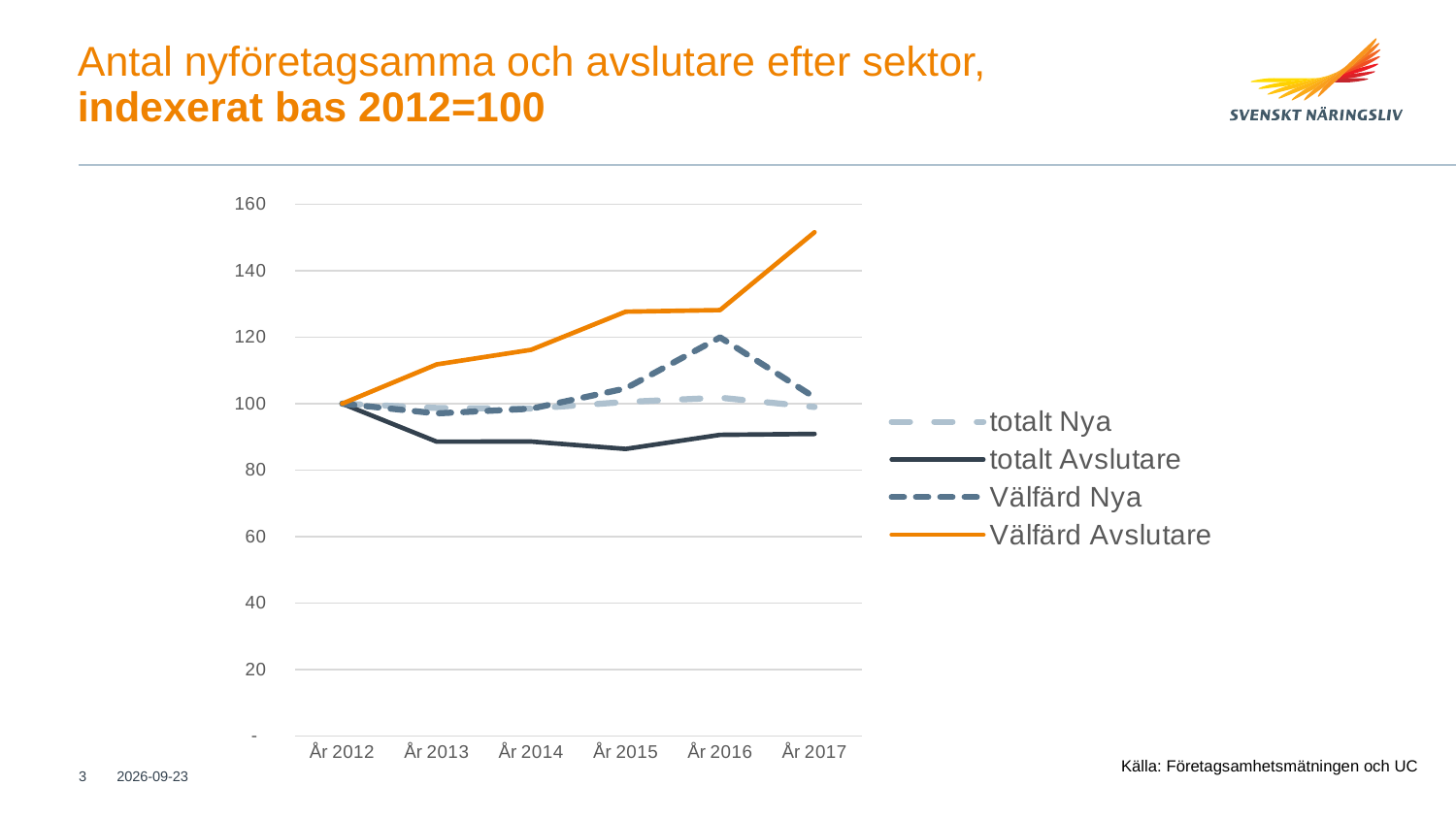
Is the value for Välfärd Avslutare in År 2017 greater or less than 140? greater Which series is drawn in orange? Välfärd Avslutare Is the value for totalt Avslutare in År 2015 greater or less than 100? less Is the value for Välfärd Avslutare in År 2015 greater or less than 120? greater What is the value for Välfärd Avslutare in År 2012? 100 What kind of chart is shown on the slide? line chart How many years are shown on the x axis? 6 How many series does the legend list? 4 Does the Välfärd Avslutare line rise or fall from År 2012 to År 2017? rise In År 2016, which is larger: Välfärd Avslutare or totalt Nya? Välfärd Avslutare Which series has the highest value in År 2017? Välfärd Avslutare Which series has the lowest value in År 2017? totalt Avslutare